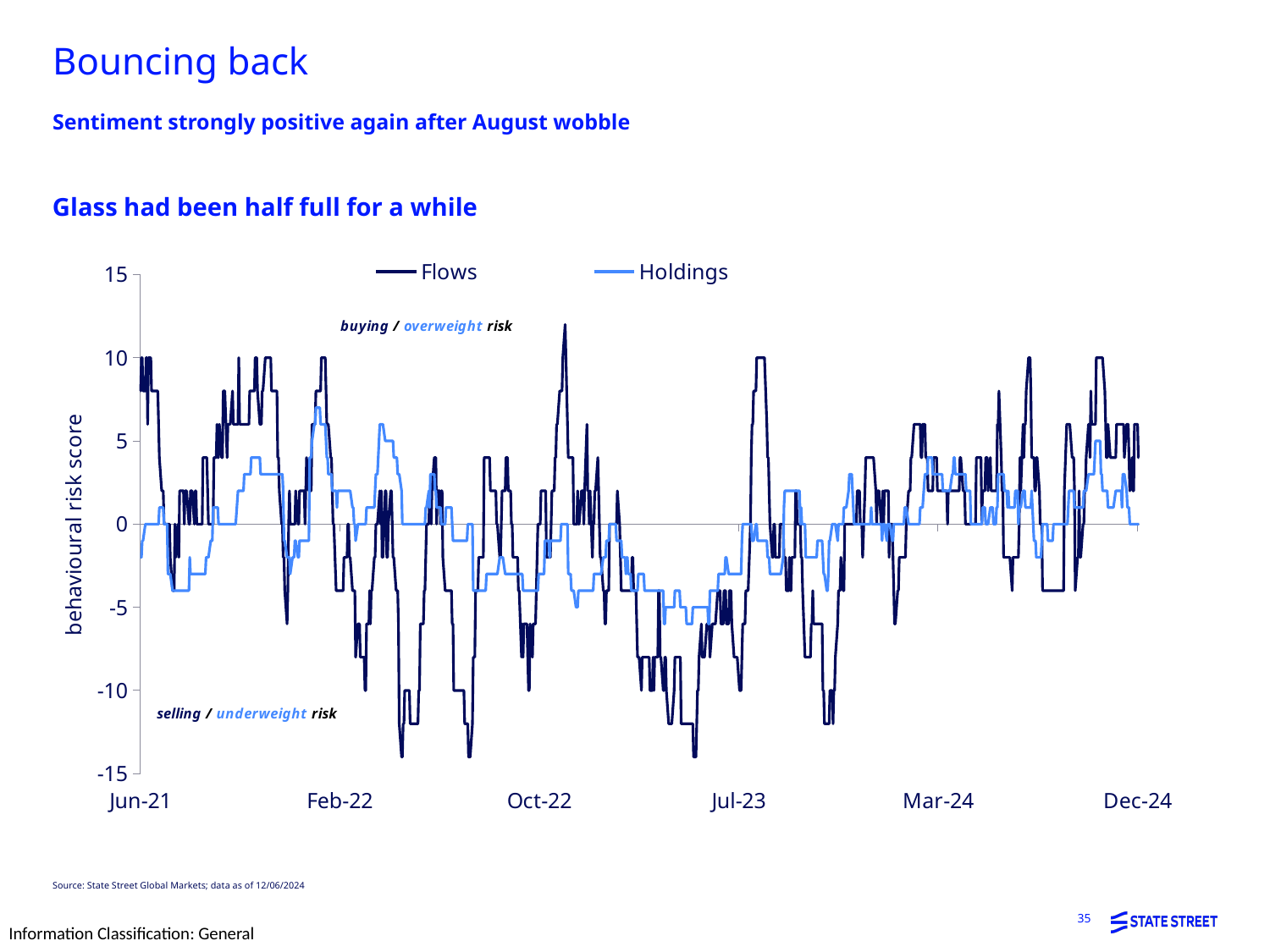
Is the lowest value reached by the Flows series greater or less than -10? less What kind of chart is shown on the slide? line chart How many date labels are shown along the chart's x axis? 6 Is the lowest value reached by the Holdings series greater or less than -10? greater Which series reaches the higher peak value, Flows or Holdings? Flows Which series reaches the lower trough value, Flows or Holdings? Flows How many series does the chart's legend list? 2 Is the Flows series at the end of the chart (Dec-24) greater or less than 0? greater What are the two series named in the chart's legend? Flows and Holdings What is the label on the chart's vertical axis? behavioural risk score